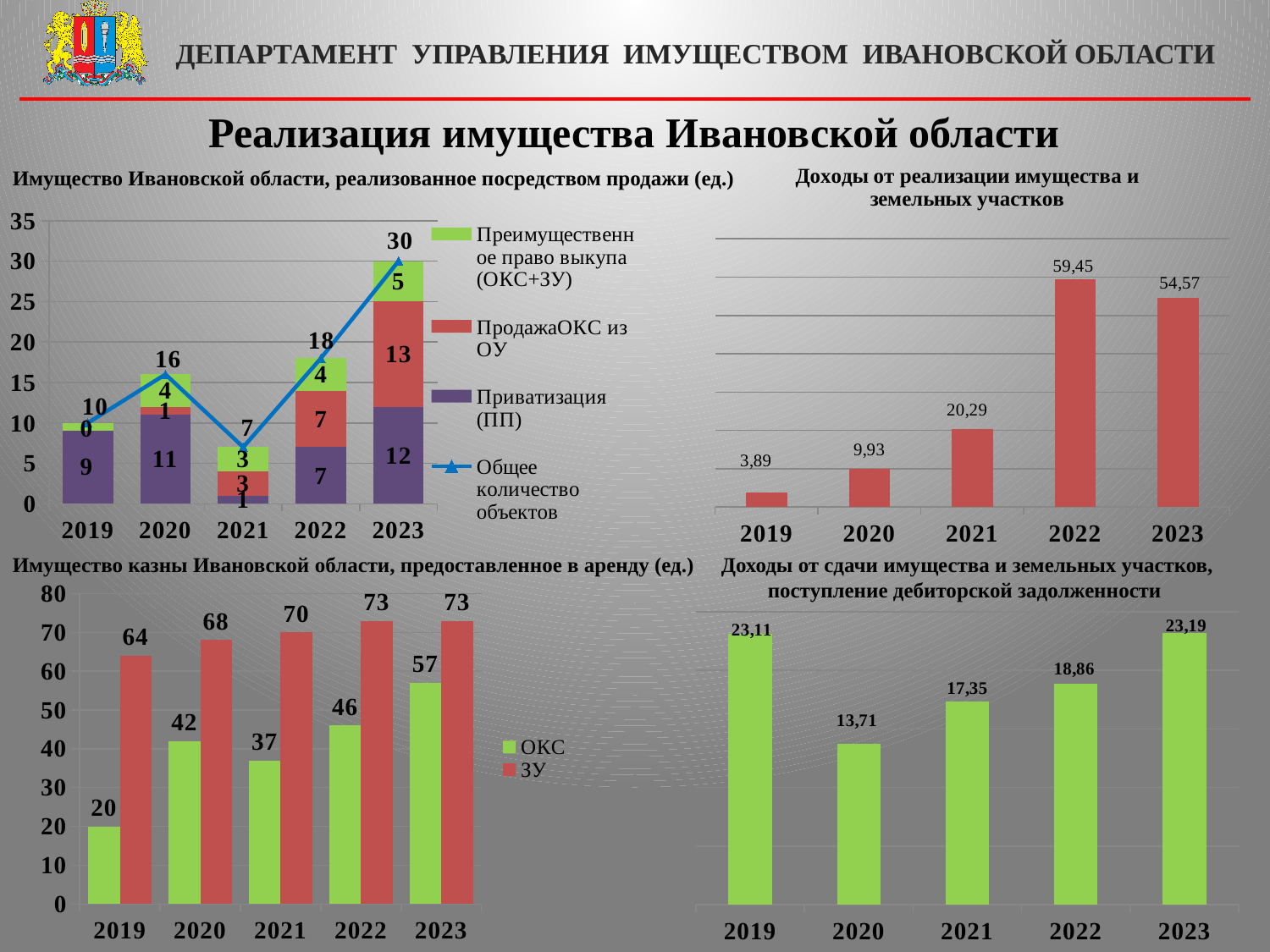
In the chart 'Имущество казны Ивановской области, предоставленное в аренду (ед.)', how many series does the legend list? 2 In the chart 'Доходы от реализации имущества и земельных участков', what is the difference between the 2022 and 2023 values? 4,88 In the chart 'Доходы от реализации имущества и земельных участков', what is the value for 2022? 59,45 In the chart 'Имущество казны Ивановской области, предоставленное в аренду (ед.)', what is the ОКС value for 2023? 57 In the chart 'Доходы от реализации имущества и земельных участков', which year has the lowest value? 2019 What type of chart is 'Доходы от реализации имущества и земельных участков'? Bar chart In the chart 'Имущество казны Ивановской области, предоставленное в аренду (ед.)', which is larger in 2019: ОКС or ЗУ? ЗУ In the chart 'Доходы от сдачи имущества и земельных участков, поступление дебиторской задолженности', what is the value for 2021? 17,35 In the chart 'Доходы от сдачи имущества и земельных участков, поступление дебиторской задолженности', which year has the highest value? 2023 In the chart 'Имущество казны Ивановской области, предоставленное в аренду (ед.)', what is the difference between ЗУ and ОКС in 2020? 26 In the chart 'Имущество Ивановской области, реализованное посредством продажи (ед.)', what is the total number of objects (Общее количество объектов) for 2023? 30 In the chart 'Имущество Ивановской области, реализованное посредством продажи (ед.)', what is the Приватизация (ПП) value for 2020? 11